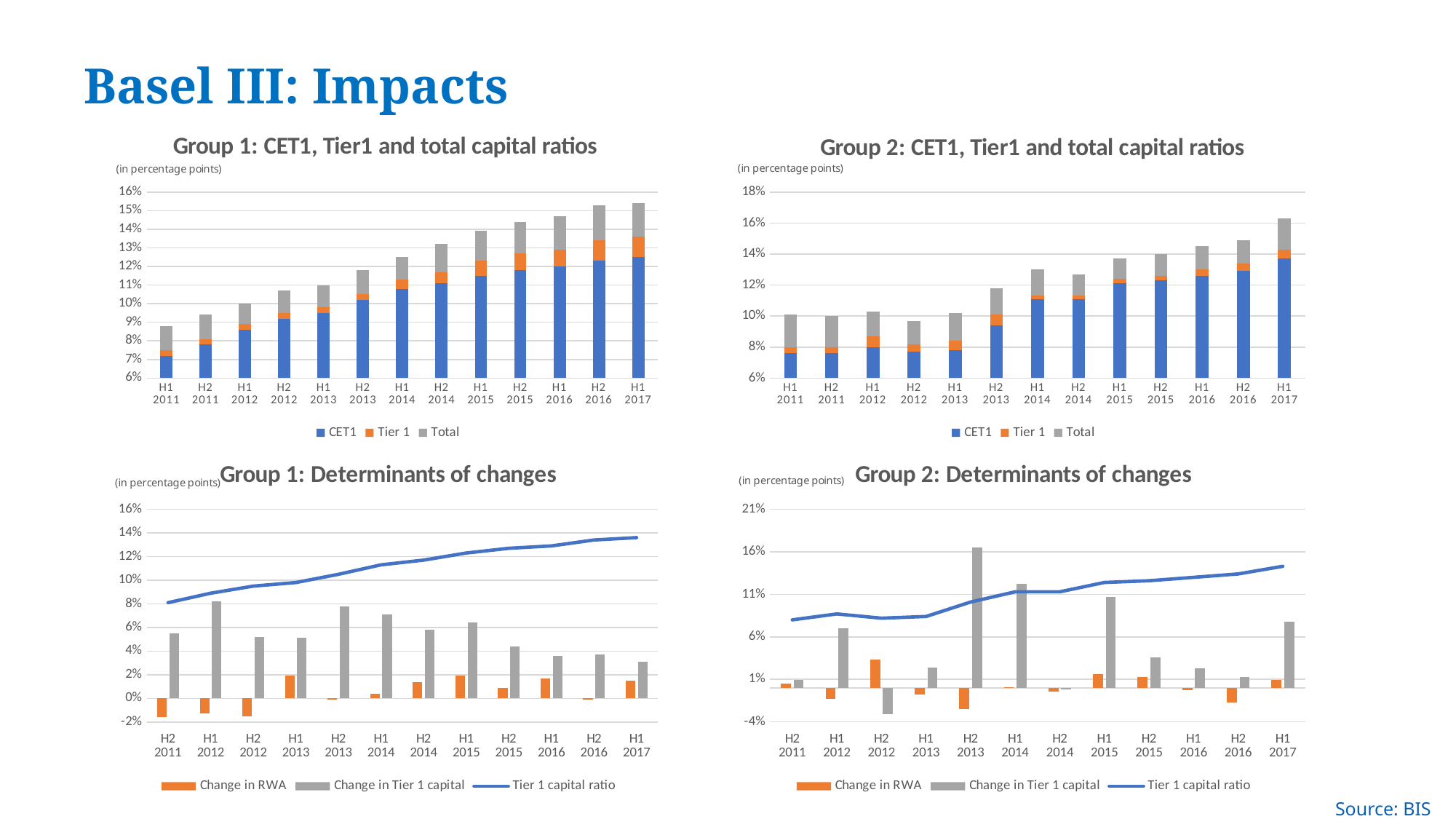
In the 'Group 2: Determinants of changes' chart, which period has the highest Change in RWA bar? H2 2012 In the 'Group 1: CET1, Tier1 and total capital ratios' chart, which period has the shortest stacked bar? H1 2011 In the 'Group 1: Determinants of changes' chart, which is larger: the Change in Tier 1 capital for H1 2012 or for H1 2017? H1 2012 In the 'Group 1: CET1, Tier1 and total capital ratios' chart, which period has the tallest stacked bar? H1 2017 In the 'Group 2: CET1, Tier1 and total capital ratios' chart, do the stacked bars generally rise or fall from H1 2011 to H1 2017? Rise In the 'Group 1: Determinants of changes' chart, which period has the highest Change in Tier 1 capital bar? H1 2012 In the 'Group 1: Determinants of changes' chart, is the Tier 1 capital ratio for H1 2017 greater or less than 12%? greater What type of chart is the 'Group 1: CET1, Tier1 and total capital ratios' chart? Stacked bar chart In the 'Group 2: CET1, Tier1 and total capital ratios' chart, is the top of the stacked bar for H1 2017 greater or less than 16%? greater How many periods are shown on the x axis of the 'Group 1: CET1, Tier1 and total capital ratios' chart? 13 How many series does the legend list in the 'Group 2: CET1, Tier1 and total capital ratios' chart? 3